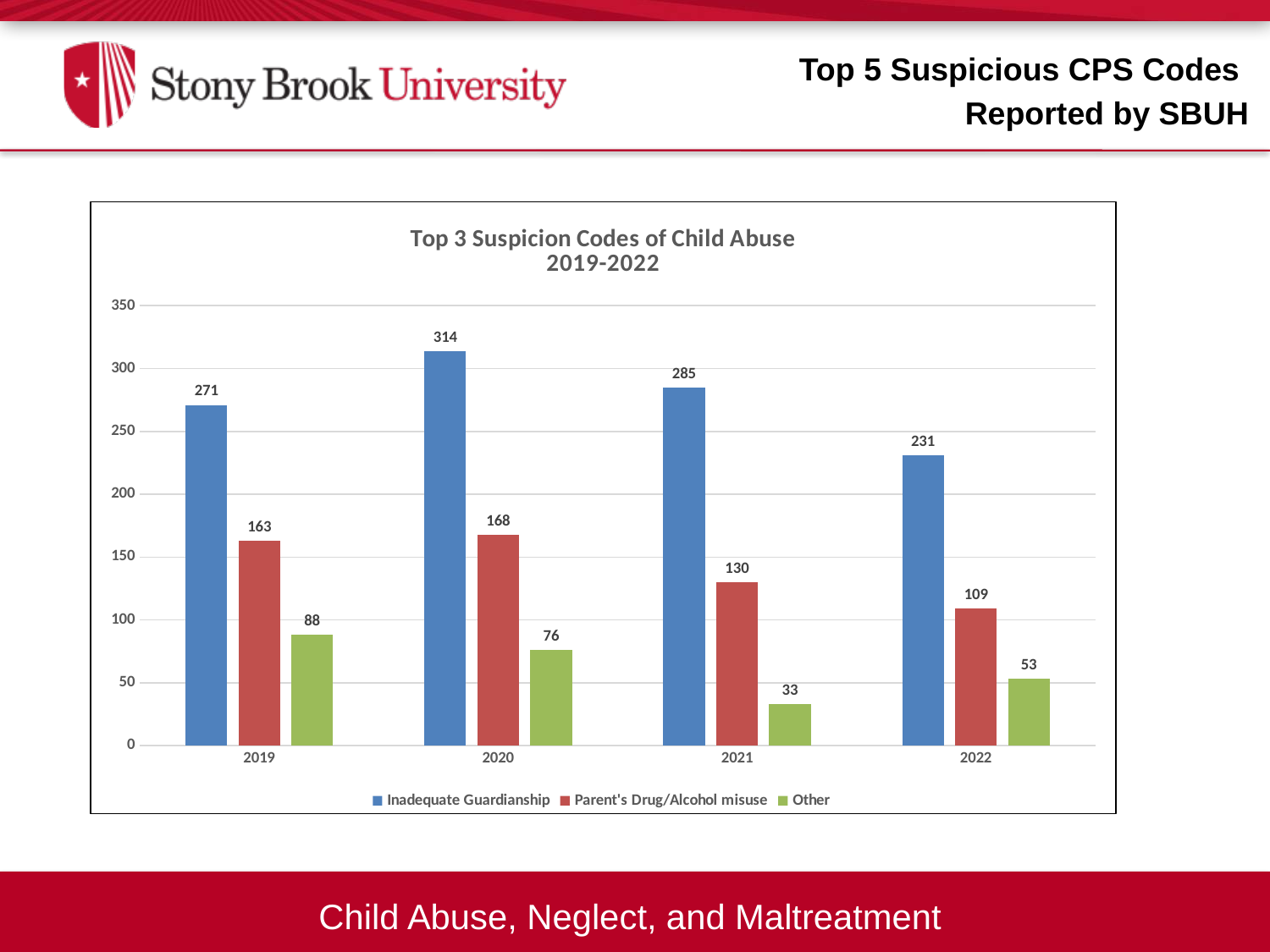
In which year is the Other value lowest? 2021 What is the value for Other in 2022? 53 In which year is the Inadequate Guardianship value highest? 2020 How many years are shown on the x axis? 4 What is the value for Parent's Drug/Alcohol misuse in 2021? 130 Which is larger: Parent's Drug/Alcohol misuse in 2020 or in 2022? 2020 How many series does the legend list? 3 What is the value for Inadequate Guardianship in 2020? 314 What is the title of the chart? Top 3 Suspicion Codes of Child Abuse 2019-2022 What is the difference between Inadequate Guardianship and Parent's Drug/Alcohol misuse in 2019? 108 What kind of chart is shown? bar chart Is the value for Inadequate Guardianship in 2022 greater or less than 250? less